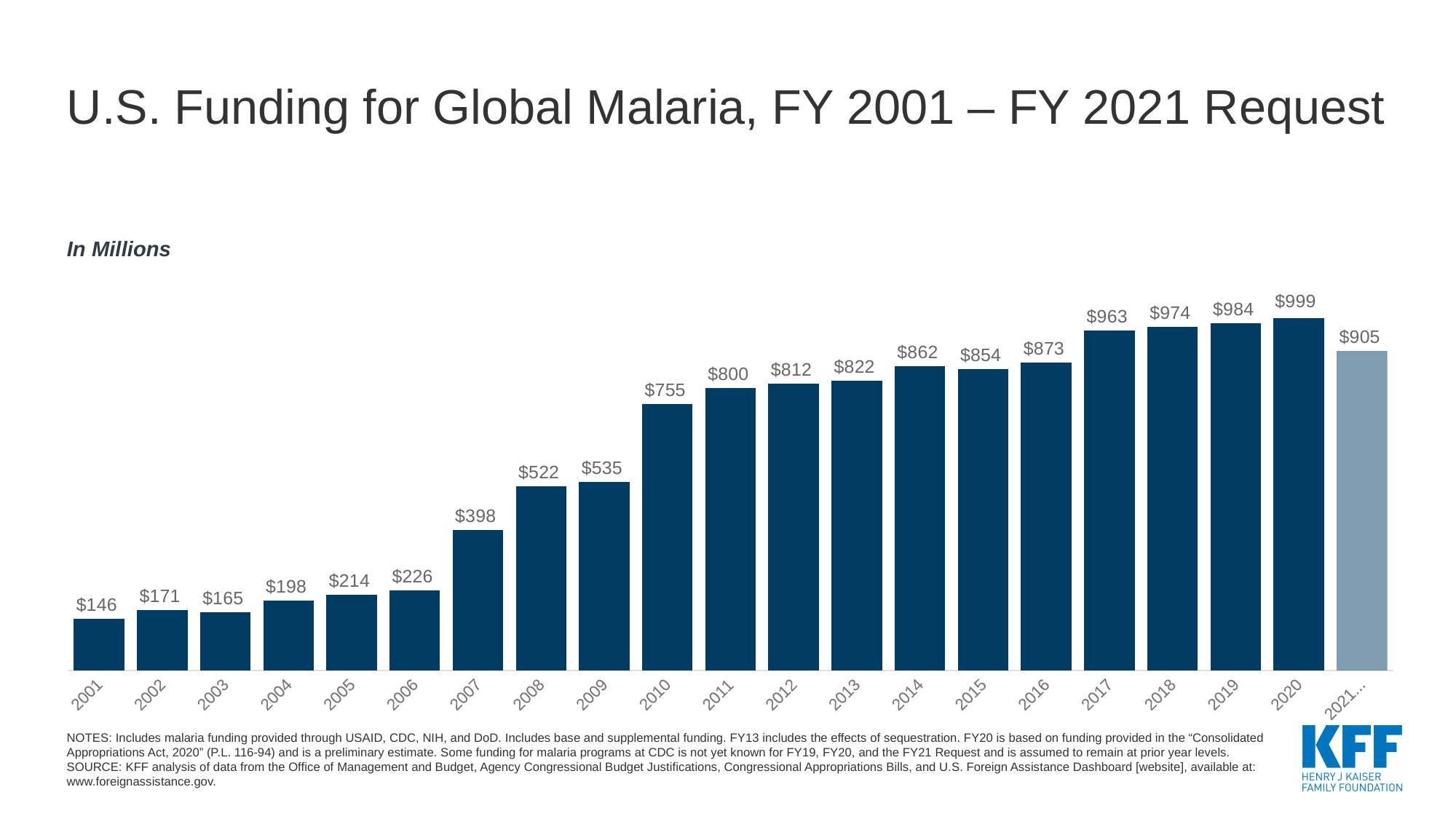
What is the FY 2021 Request value shown on the chart? $905 What is the difference between the 2020 value and the 2021 Request value? $94 How much did funding increase from 2009 to 2010? $220 Which year has the highest funding value on the chart? 2020 What type of chart is shown on the slide? Bar chart Do the values generally rise or fall from 2001 to 2020? Rise What was U.S. funding for global malaria in FY 2010? $755 What is the value shown for 2001? $146 Which year has the lowest funding value on the chart? 2001 Which is larger, the value for 2014 or the value for 2015? 2014 How many bars are plotted on the chart? 21 What unit label is shown above the chart? In Millions